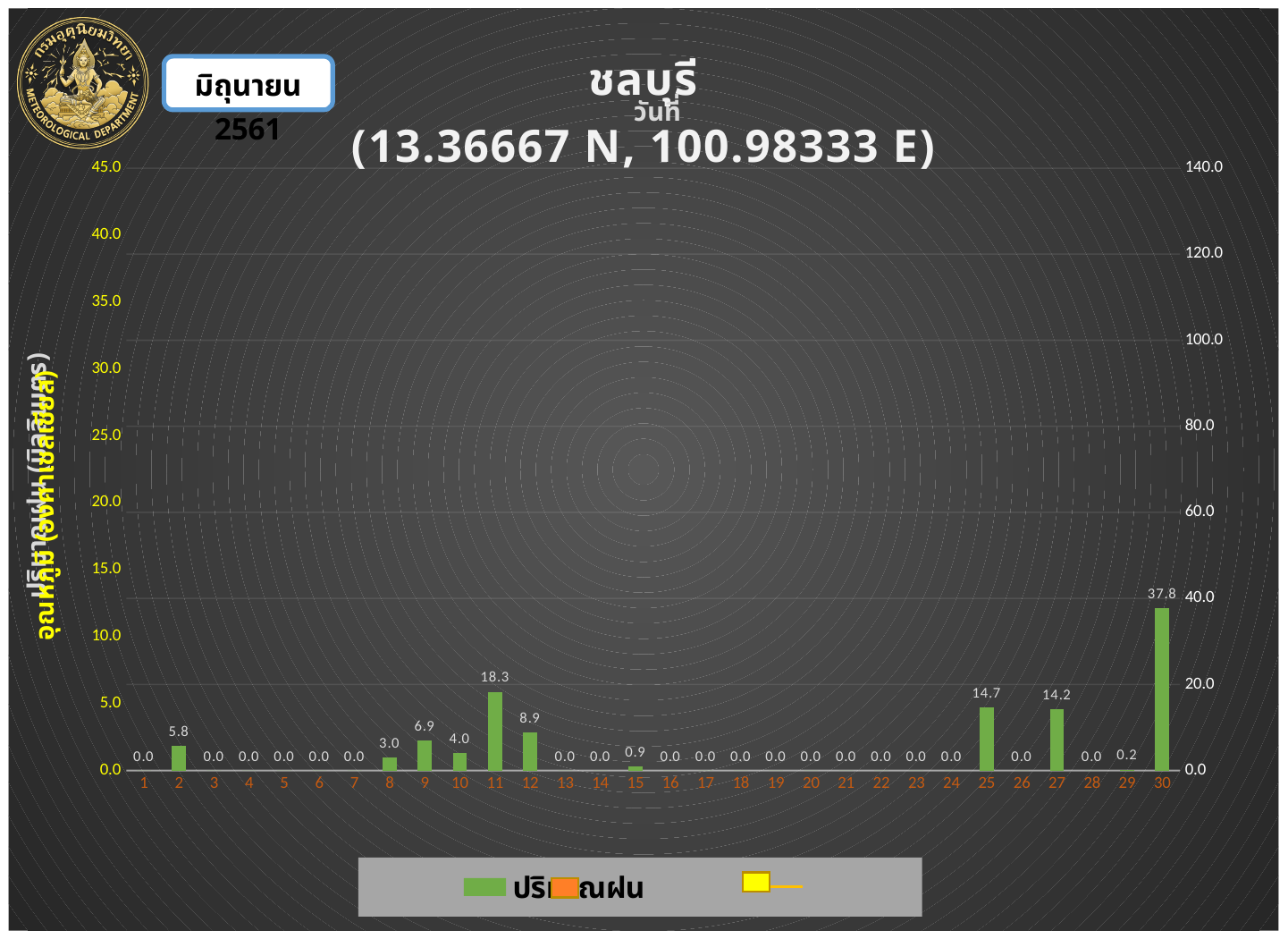
What is the rainfall value shown for day 25? 14.7 What is the rainfall value shown for day 2? 5.8 Which has a larger rainfall value, day 9 or day 10? day 9 How many days are shown on the x axis? 30 Which day has the highest rainfall value? 30 What is the difference between the rainfall values for day 30 and day 11? 19.5 Is the value for day 30 greater or less than 20.0 on the right-hand axis? greater What is the difference between the rainfall values for day 25 and day 27? 0.5 What is the rainfall value shown for day 30? 37.8 What kind of chart is shown on the slide? bar chart What is the station name shown in the chart title? ชลบุรี What is the rainfall value shown for day 11? 18.3